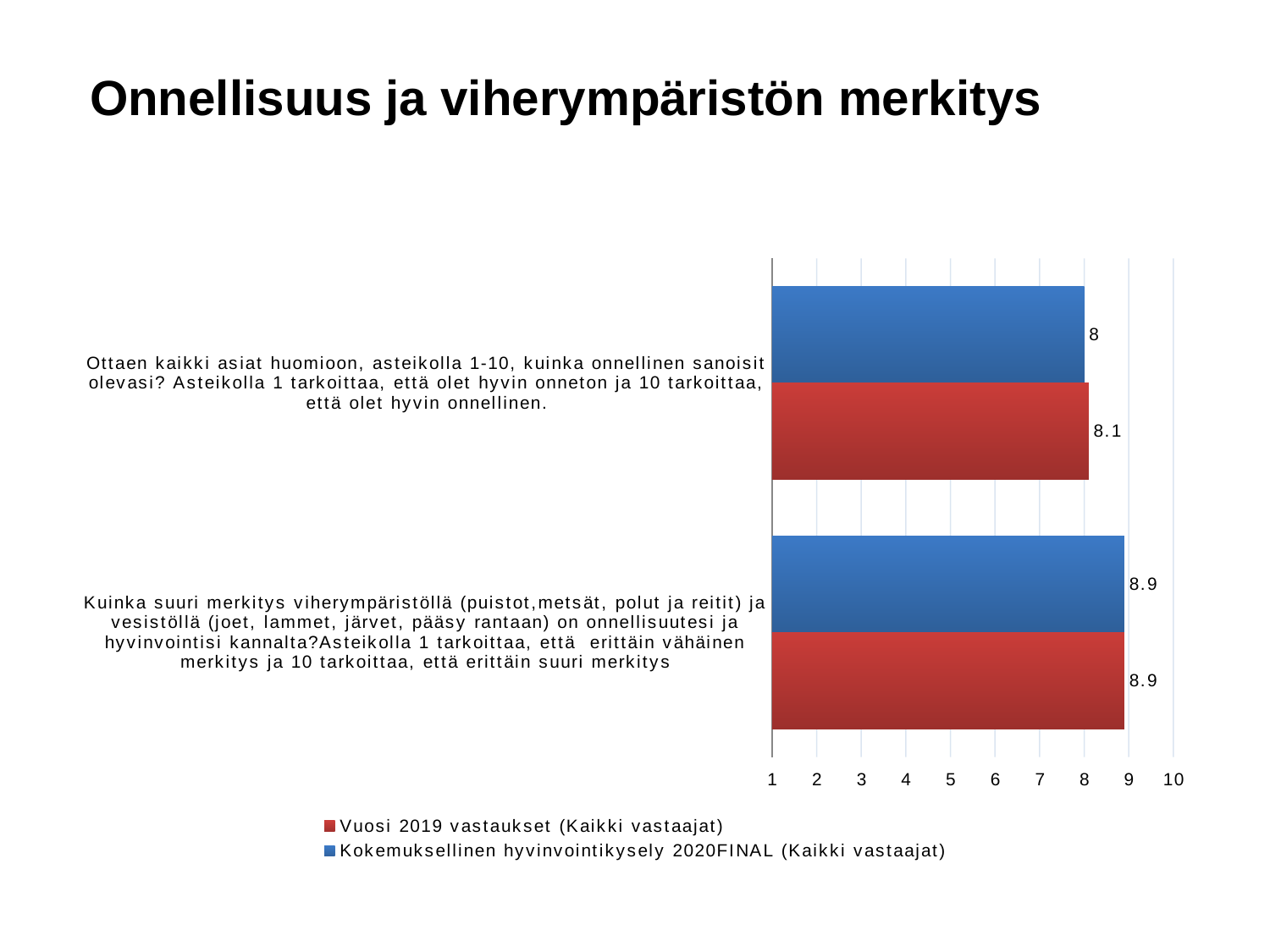
Is the value for 'Kokemuksellinen hyvinvointikysely 2020FINAL (Kaikki vastaajat)' on the happiness question ('Ottaen kaikki asiat huomioon...') greater or less than 9? less Which series has the lowest value on the chart? Kokemuksellinen hyvinvointikysely 2020FINAL (Kaikki vastaajat) How many series does the legend list? 2 What is the difference between the 2019 value (8.1) and the 2020FINAL value (8) for the question 'Ottaen kaikki asiat huomioon, asteikolla 1-10, kuinka onnellinen sanoisit olevasi?' 0.1 What is the value for 'Vuosi 2019 vastaukset (Kaikki vastaajat)' on the question 'Kuinka suuri merkitys viherympäristöllä ... on onnellisuutesi ja hyvinvointisi kannalta?' 8.9 What kind of chart is shown on the slide? Bar chart Which question has the higher value for 'Vuosi 2019 vastaukset (Kaikki vastaajat)'? Kuinka suuri merkitys viherympäristöllä (puistot, metsät, polut ja reitit) ja vesistöllä (joet, lammet, järvet, pääsy rantaan) on onnellisuutesi ja hyvinvointisi kannalta? What is the value for 'Kokemuksellinen hyvinvointikysely 2020FINAL (Kaikki vastaajat)' on the question 'Ottaen kaikki asiat huomioon, asteikolla 1-10, kuinka onnellinen sanoisit olevasi?' 8 What is the value for 'Vuosi 2019 vastaukset (Kaikki vastaajat)' on the question 'Ottaen kaikki asiat huomioon, asteikolla 1-10, kuinka onnellinen sanoisit olevasi?' 8.1 What is the value for 'Kokemuksellinen hyvinvointikysely 2020FINAL (Kaikki vastaajat)' on the question 'Kuinka suuri merkitys viherympäristöllä ... on onnellisuutesi ja hyvinvointisi kannalta?' 8.9 How many question categories are plotted on the chart? 2 What colour are the bars for 'Vuosi 2019 vastaukset (Kaikki vastaajat)'? Red